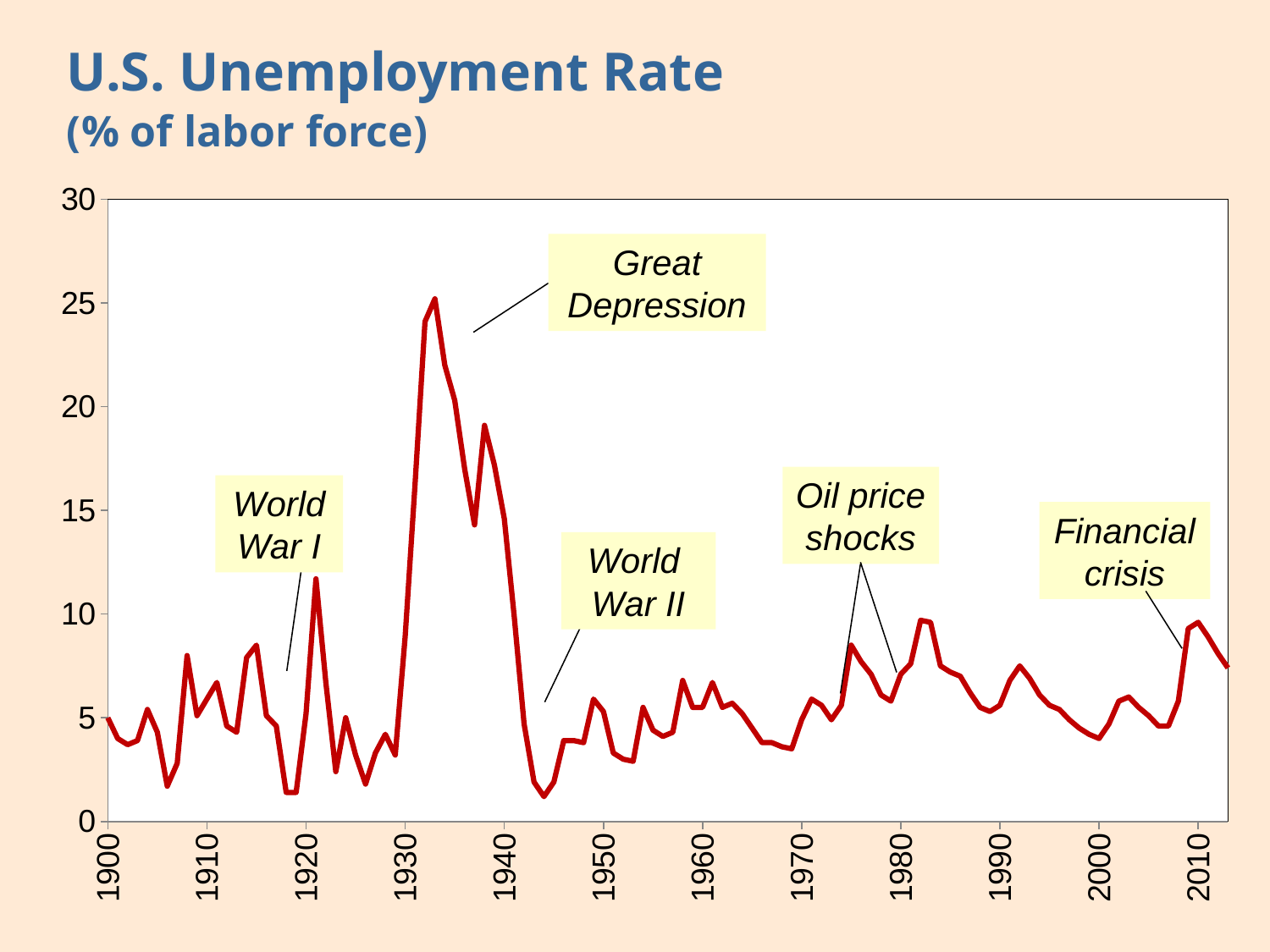
What is the title of the chart? U.S. Unemployment Rate (% of labor force) Which peak is higher: the Great Depression peak or the Financial crisis peak? Great Depression Is the peak unemployment rate during the Great Depression greater or less than 20? greater Is the unemployment rate in 1940 greater or less than 10? greater Which annotated event corresponds to the highest unemployment rate on the chart? Great Depression Is the unemployment rate in 1944 greater or less than 5? less Does the unemployment rate rise or fall between 1929 and 1933? rise How many annotated events are labeled on the chart? 5 What kind of chart is shown on the slide? line chart Does the unemployment rate rise or fall between 1933 and 1944? fall